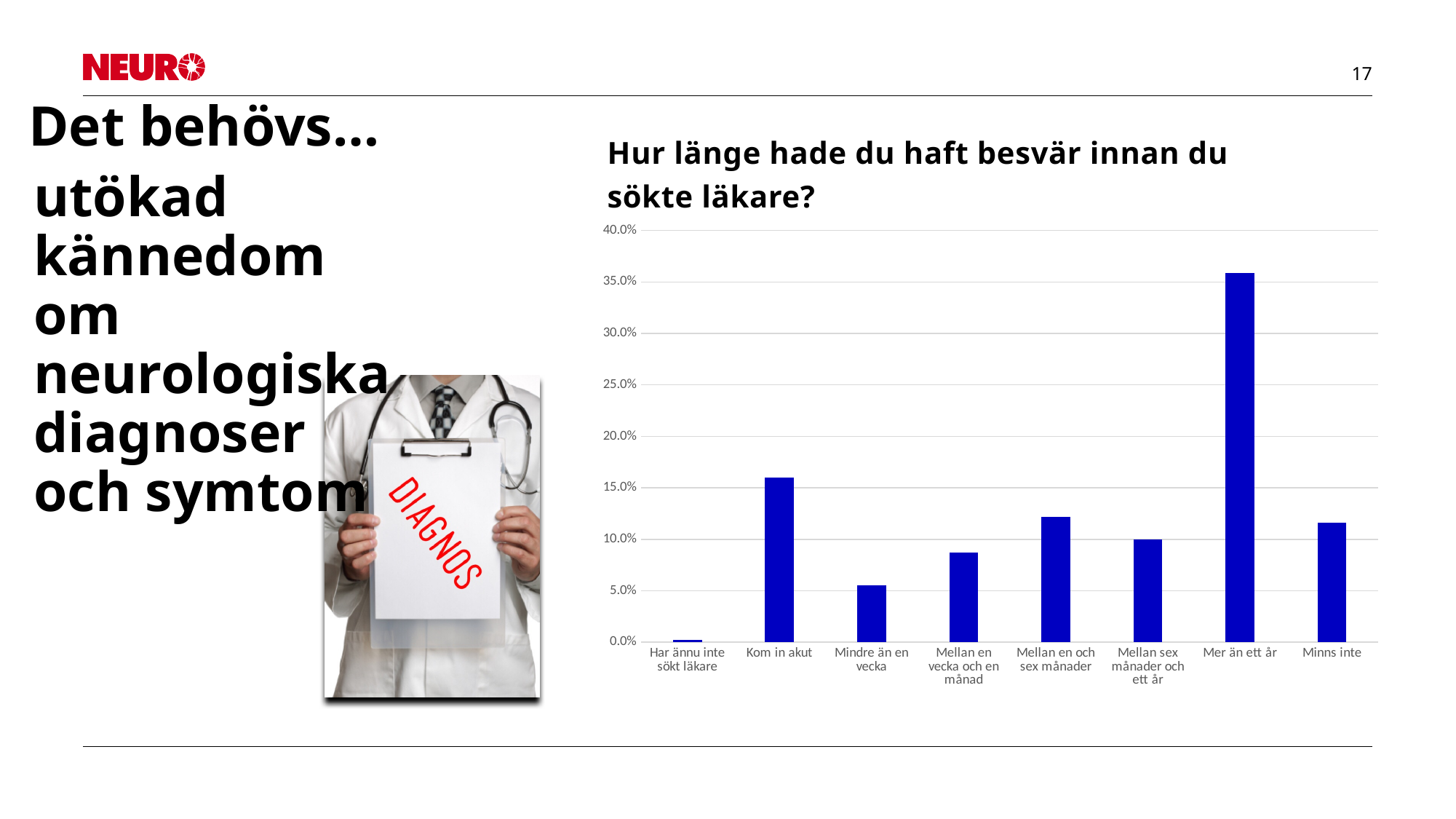
What is the title of the chart? Hur länge hade du haft besvär innan du sökte läkare? Which category has the highest value in the chart? Mer än ett år Which category has the lowest value in the chart? Har ännu inte sökt läkare What kind of chart is shown on the slide? bar chart Is the value for Minns inte greater or less than 15.0%? less Which is larger, the value for Kom in akut or the value for Mellan en och sex månader? Kom in akut How many categories are shown on the x axis of the chart? 8 Is the value for Mer än ett år greater or less than 30.0%? greater Is the value for Mellan en vecka och en månad greater or less than 10.0%? less Which is larger, the value for Mindre än en vecka or the value for Mellan en vecka och en månad? Mellan en vecka och en månad